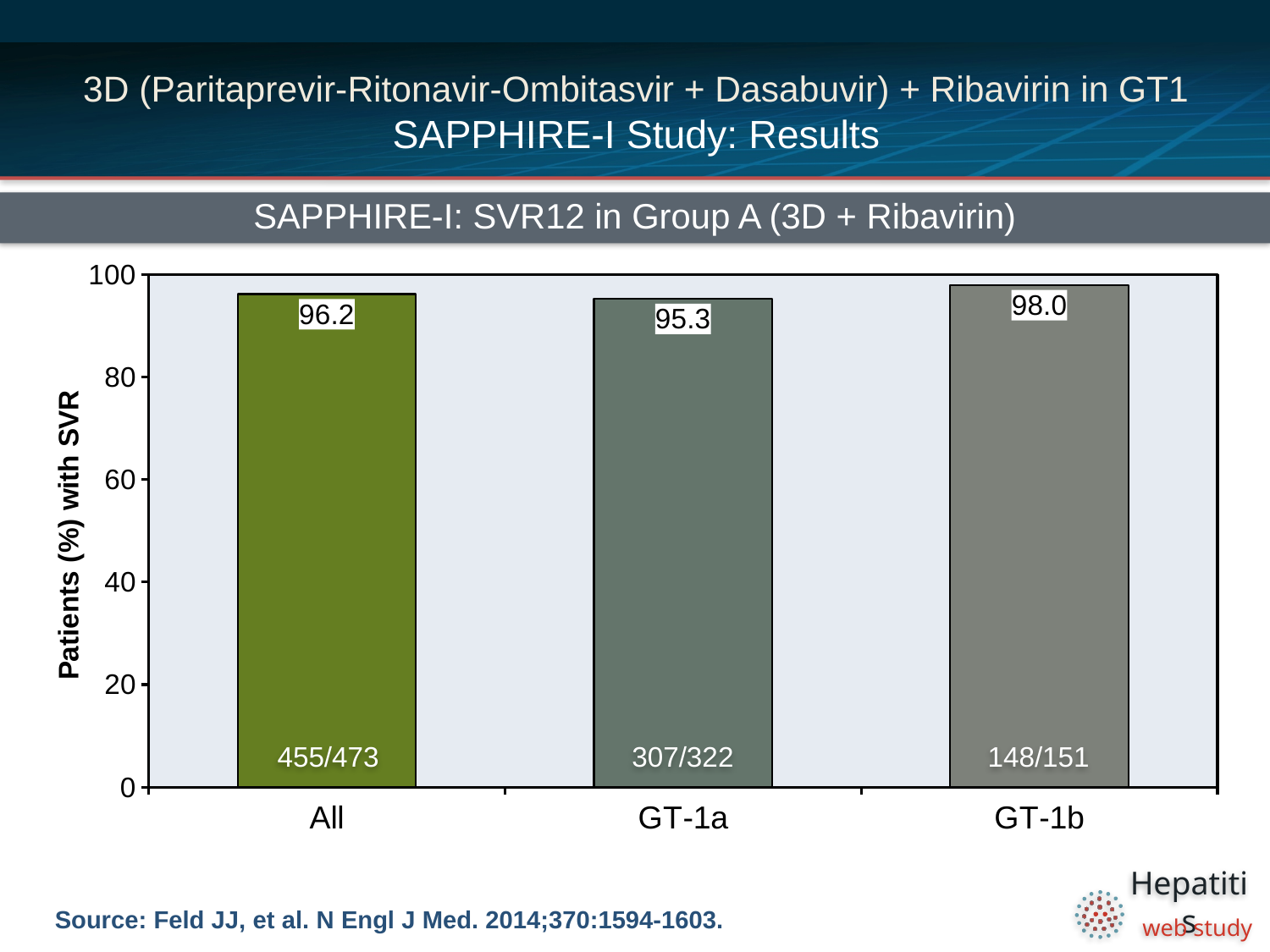
What is the difference between the SVR12 rates for GT-1b and GT-1a? 2.7 Which category has the highest SVR12 rate? GT-1b What kind of chart is shown on the slide? Bar chart What is the SVR12 rate for the All group? 96.2 What is the SVR12 rate for GT-1a? 95.3 Which category has the lowest SVR12 rate? GT-1a What fraction of patients is shown inside the All bar? 455/473 How many categories are shown on the x axis? 3 What is the label of the y axis? Patients (%) with SVR What is the SVR12 rate for GT-1b? 98.0 Which has a higher SVR12 rate, All or GT-1a? All What fraction of patients is shown inside the GT-1a bar? 307/322